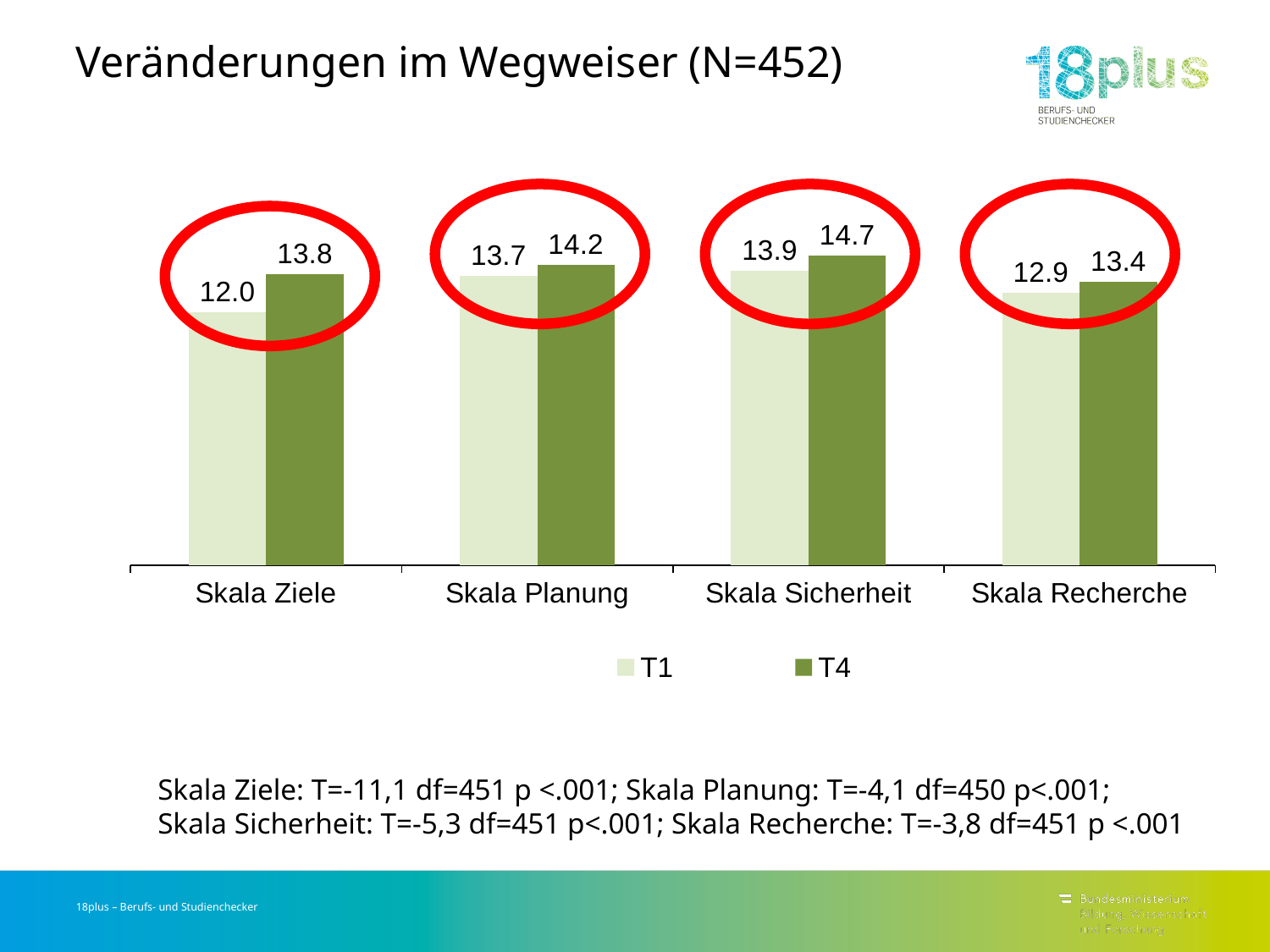
What is the difference between the T4 and T1 values for Skala Recherche? 0.5 What is the T1 value for Skala Recherche? 12.9 Which category has the lowest T1 value? Skala Ziele What is the T1 value for Skala Ziele? 12.0 What is the difference between the T4 and T1 values for Skala Ziele? 1.8 What is the T4 value for Skala Sicherheit? 14.7 Which is larger for Skala Planung, the T1 value or the T4 value? T4 How many categories are shown on the x axis? 4 Which category has the highest T4 value? Skala Sicherheit What is the T4 value for Skala Planung? 14.2 How many series does the legend list? 2 What kind of chart is shown on the slide? Bar chart